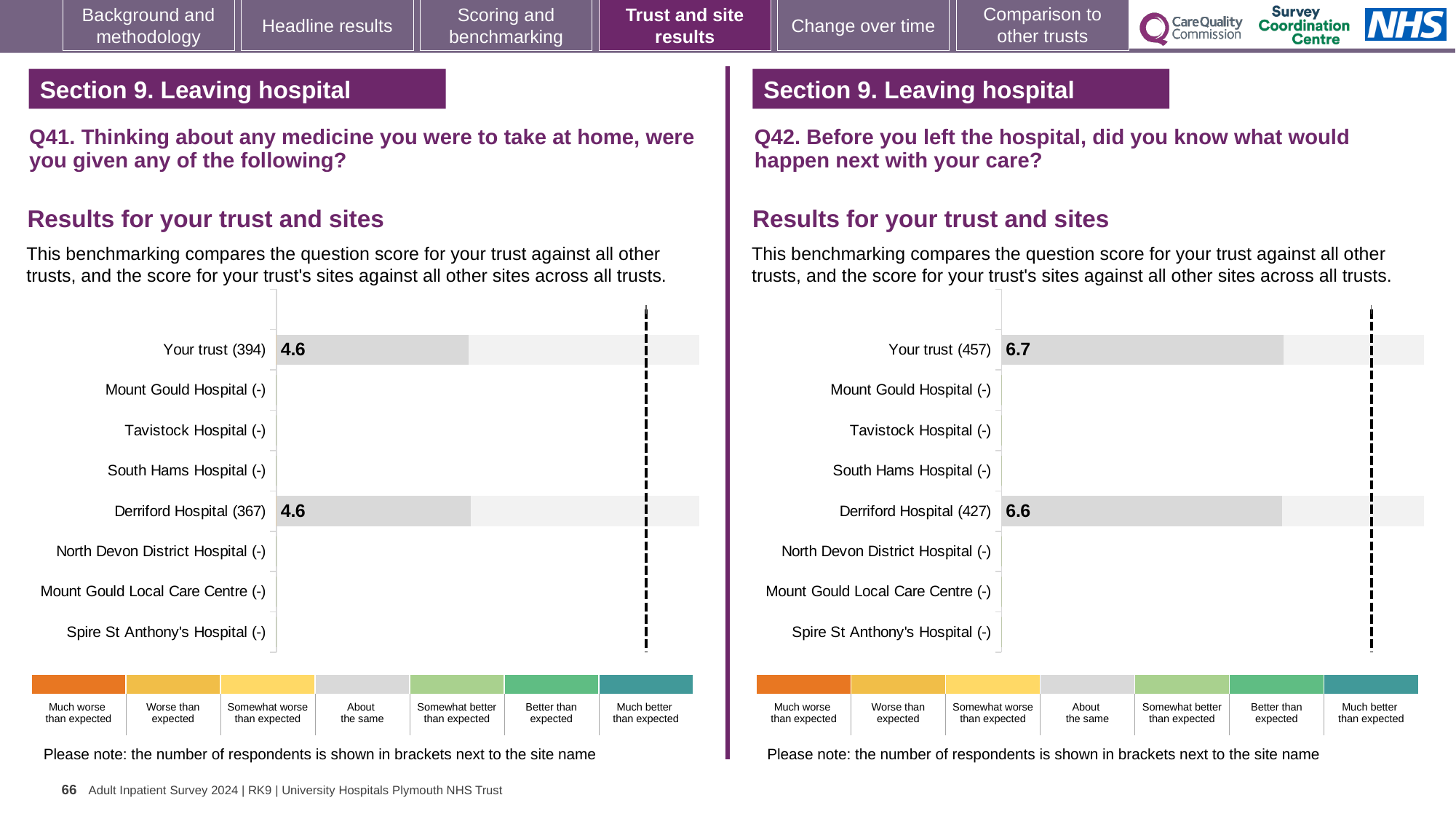
In the Q41 chart on the left, what is the score for Your trust? 4.6 In the Q42 chart on the right, what is the difference between the scores for Your trust and Derriford Hospital? 0.1 In the Q42 chart on the right, what is the score for Your trust? 6.7 In the Q41 chart on the left, how many respondents are shown in brackets for Derriford Hospital? 367 In the Q42 chart on the right, how many respondents are shown in brackets for Your trust? 457 In the Q41 chart on the left, what is the difference between the scores for Your trust and Derriford Hospital? 0 In the Q41 chart on the left, what is the score for Derriford Hospital? 4.6 What kind of chart is used for the Q42 results on the right? Bar chart How many site categories are listed on the y axis of the Q41 chart on the left? 8 In the Q41 chart on the left, which benchmark category does the colour key label furthest to the right represent? Much better than expected In the Q42 chart on the right, what is the score for Derriford Hospital? 6.6 In the Q42 chart on the right, which has the higher score, Your trust or Derriford Hospital? Your trust